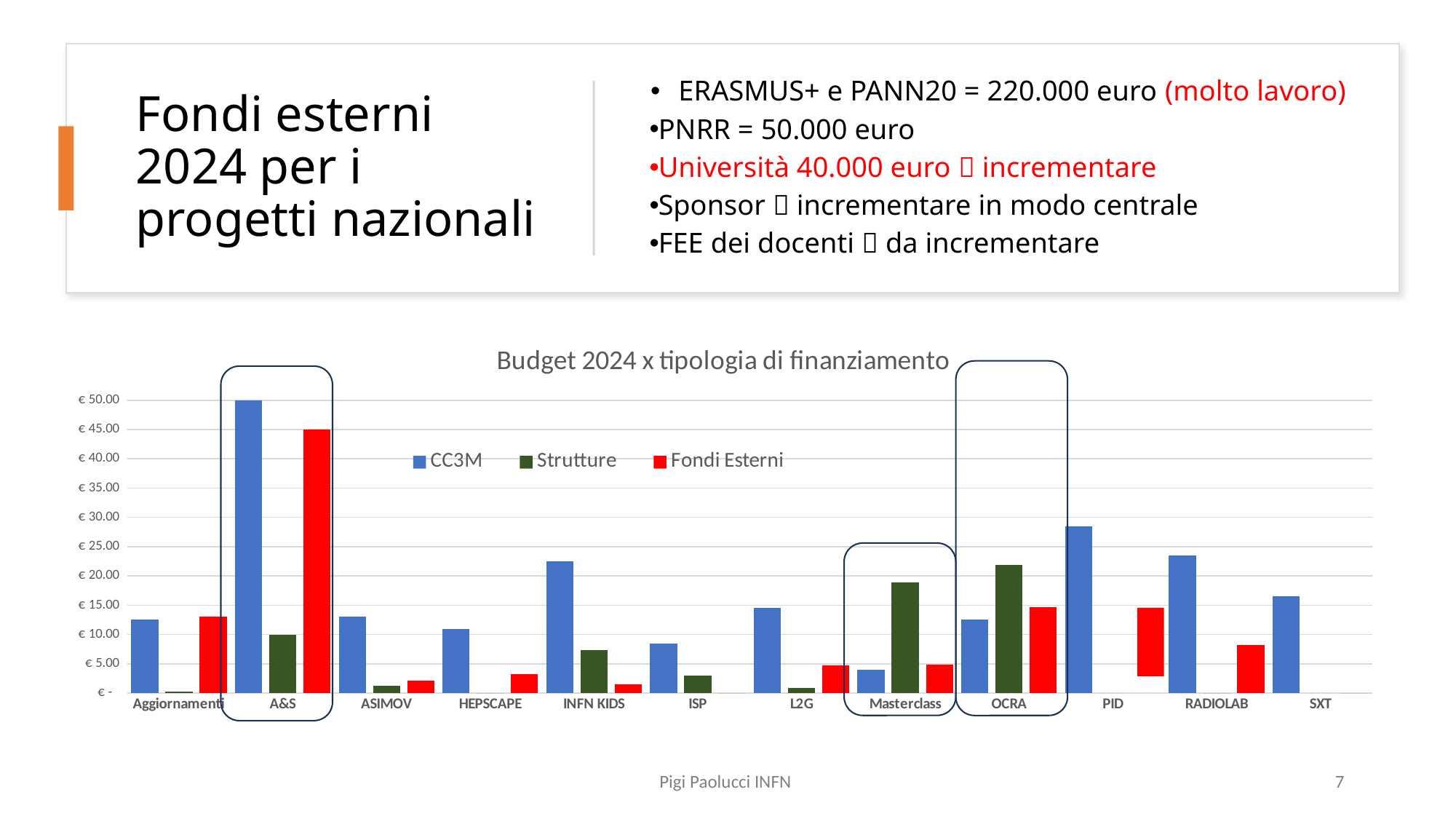
Which category has the highest Fondi Esterni value? A&S Is the Fondi Esterni value for A&S greater or less than 40? greater How many series does the legend of the chart list? 3 Is the CC3M value for Masterclass greater or less than 5? less Is the CC3M value for PID greater or less than 25? greater Which category has the highest CC3M value? A&S Which is larger, the CC3M value for INFN KIDS or for ASIMOV? INFN KIDS How many categories are shown on the x axis of the chart? 12 What kind of chart is shown on the slide? bar chart Which is larger, the Strutture value for OCRA or for Masterclass? OCRA